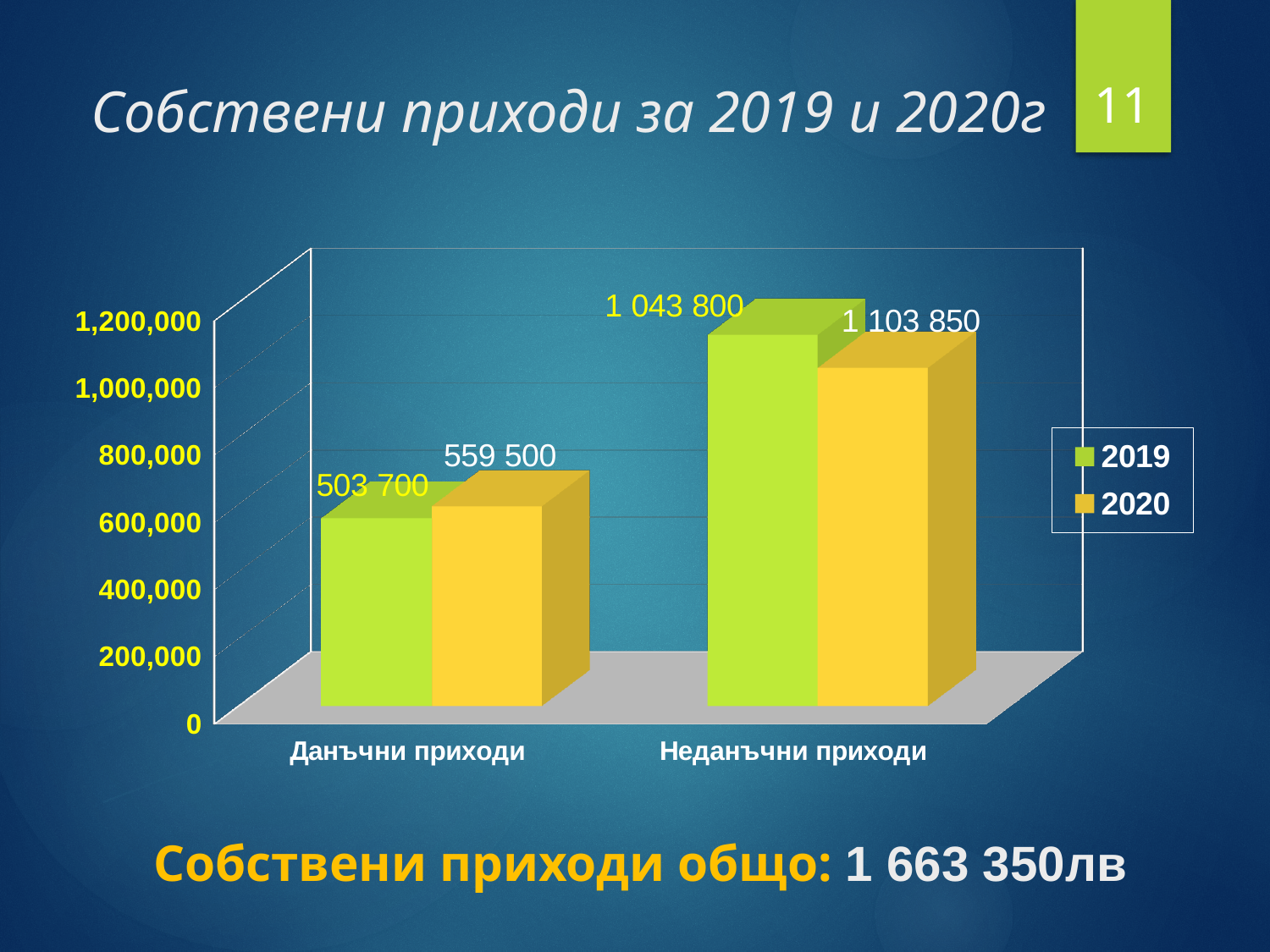
What is the value for Данъчни приходи in 2019? 503 700 How many categories are shown on the x axis? 2 Which category has the lowest value in 2019? Данъчни приходи What is the difference between the 2020 and 2019 values for Данъчни приходи? 55 800 How many series does the legend list? 2 What is the value for Неданъчни приходи in 2020? 1 103 850 What is the value for Данъчни приходи in 2020? 559 500 What kind of chart is shown on the slide? Bar chart Which category has the highest value in 2020? Неданъчни приходи Which is larger: Неданъчни приходи in 2019 or Данъчни приходи in 2020? Неданъчни приходи in 2019 What is the value for Неданъчни приходи in 2019? 1 043 800 What is the difference between the 2020 and 2019 values for Неданъчни приходи? 60 050